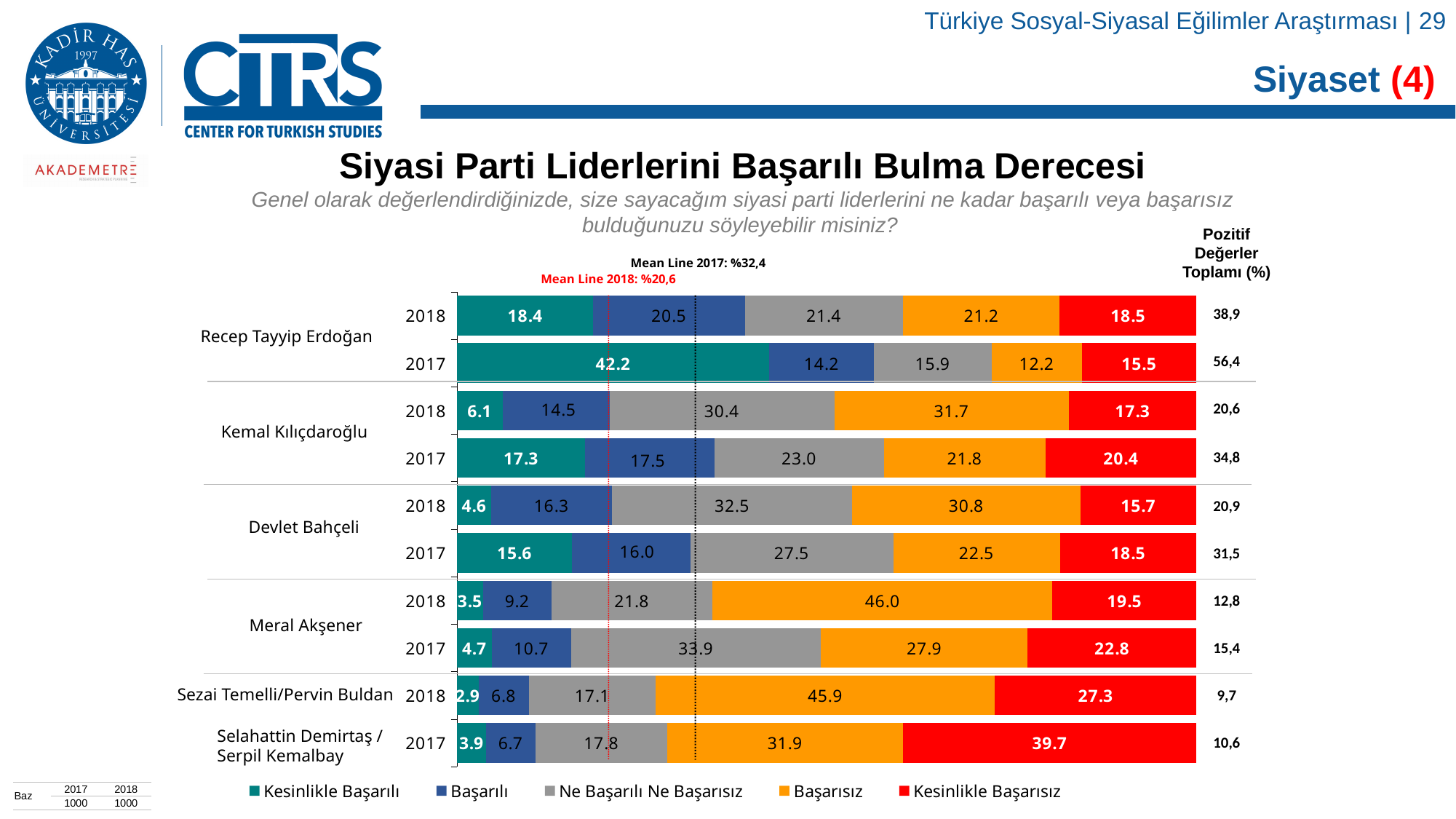
What kind of chart is shown on the slide? Stacked bar chart Which bar has the lowest 'Kesinlikle Başarılı' value on the chart? Sezai Temelli/Pervin Buldan 2018 What is the difference between Recep Tayyip Erdoğan's 'Kesinlikle Başarılı' value in 2017 and in 2018? 23.8 What is the 'Kesinlikle Başarılı' value for Recep Tayyip Erdoğan in 2017? 42.2 Which leader has the highest 'Kesinlikle Başarılı' value in 2018? Recep Tayyip Erdoğan What is the value of the Mean Line for 2018 shown on the chart? %20,6 Is the 'Ne Başarılı Ne Başarısız' value for Devlet Bahçeli in 2018 larger than that for Kemal Kılıçdaroğlu in 2018? Yes How many series does the legend list? 5 How many bars (leader-year rows) are shown on the chart? 10 What is the 'Başarısız' value for Meral Akşener in 2018? 46.0 What is the 'Pozitif Değerler Toplamı (%)' for Kemal Kılıçdaroğlu in 2018? 20,6 What is the 'Kesinlikle Başarısız' value for Selahattin Demirtaş / Serpil Kemalbay in 2017? 39.7